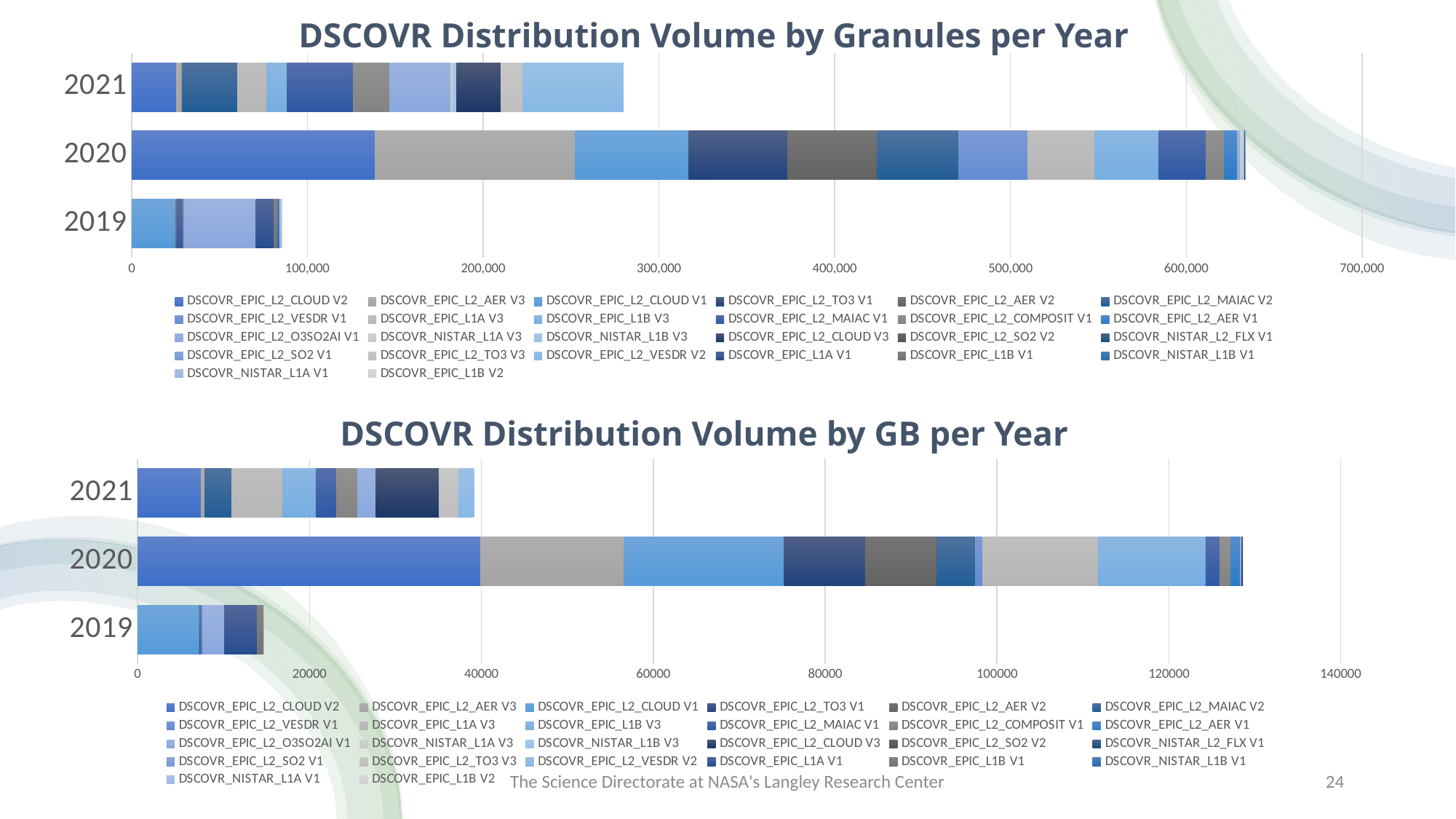
In the 'DSCOVR Distribution Volume by Granules per Year' chart, which year has the lowest total? 2019 In the 'DSCOVR Distribution Volume by Granules per Year' chart, is the total for 2019 greater or less than 100,000? less How many years are shown in the 'DSCOVR Distribution Volume by GB per Year' chart? 3 What kind of chart is the 'DSCOVR Distribution Volume by Granules per Year' chart? Stacked bar chart In the 'DSCOVR Distribution Volume by Granules per Year' chart, is the total for 2021 greater or less than 300,000? less In the 'DSCOVR Distribution Volume by GB per Year' chart, which year has the highest total? 2020 What is the title of the bottom chart on the slide? DSCOVR Distribution Volume by GB per Year How many series does the legend of the 'DSCOVR Distribution Volume by GB per Year' chart list? 26 In the 'DSCOVR Distribution Volume by Granules per Year' chart, is the total for 2020 greater or less than 600,000? greater In the 'DSCOVR Distribution Volume by Granules per Year' chart, which year has the highest total? 2020 In the 'DSCOVR Distribution Volume by GB per Year' chart, which total is larger, 2021 or 2019? 2021